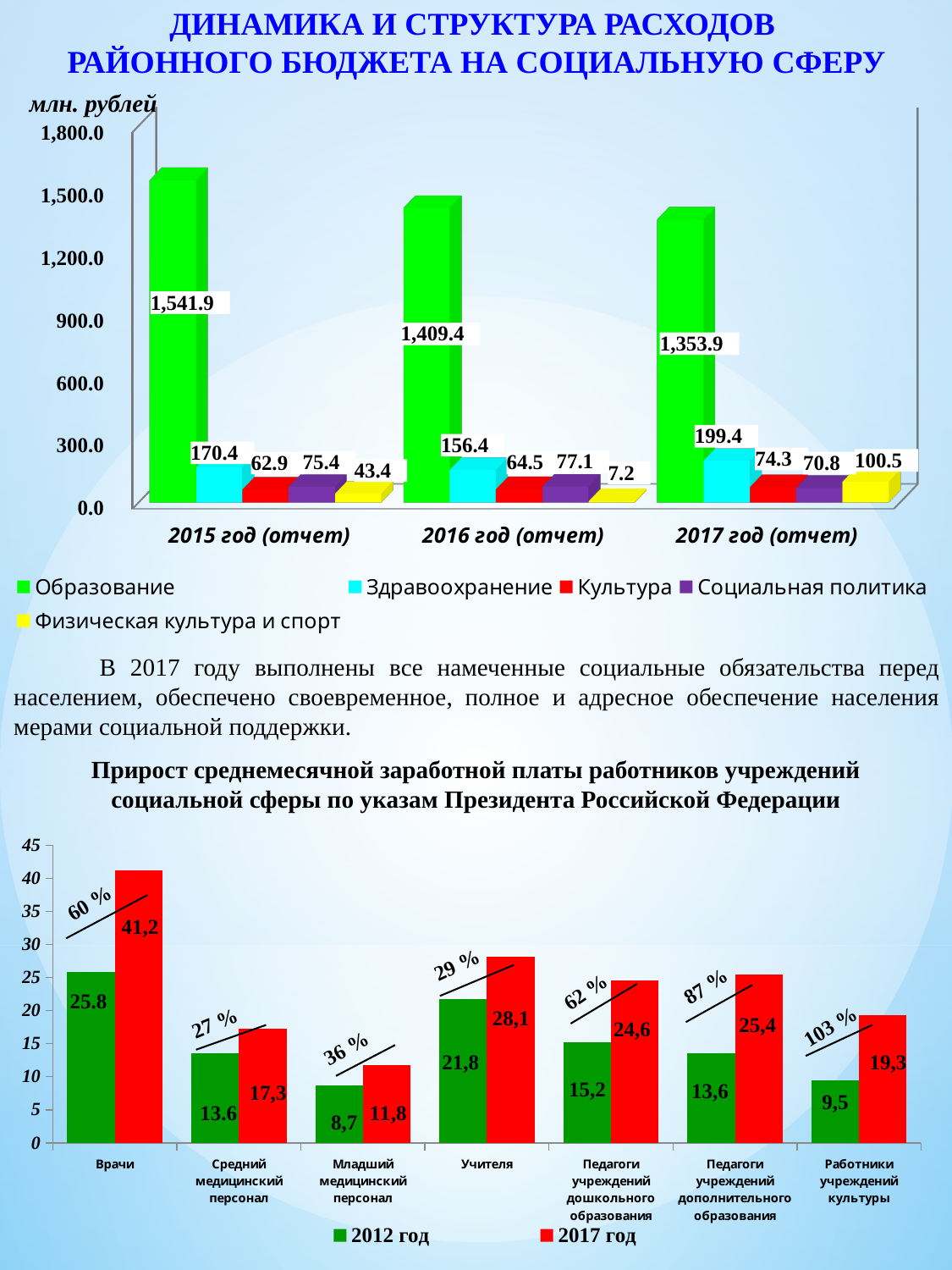
In the bottom chart (Прирост среднемесячной заработной платы), what is the 2017 год value for Врачи? 41,2 In the top chart (ДИНАМИКА И СТРУКТУРА РАСХОДОВ), what is the value for Физическая культура и спорт in 2016 год (отчет)? 7.2 How many year categories are shown on the x axis of the top chart (ДИНАМИКА И СТРУКТУРА РАСХОДОВ)? 3 What kind of chart is the bottom chart (Прирост среднемесячной заработной платы)? bar chart In the top chart (ДИНАМИКА И СТРУКТУРА РАСХОДОВ), what is the difference between the Здравоохранение values for 2017 and 2015? 29.0 In the bottom chart (Прирост среднемесячной заработной платы), which category has the lowest 2017 год value? Младший медицинский персонал In the top chart (ДИНАМИКА И СТРУКТУРА РАСХОДОВ), does the value for Образование rise or fall from 2015 to 2017? fall How many categories are shown on the x axis of the bottom chart (Прирост среднемесячной заработной платы)? 7 How many series does the legend of the top chart (ДИНАМИКА И СТРУКТУРА РАСХОДОВ) list? 5 In the bottom chart (Прирост среднемесячной заработной платы), what is the difference between the 2017 год and 2012 год values for Учителя? 6,3 In the top chart (ДИНАМИКА И СТРУКТУРА РАСХОДОВ), what is the value for Образование in 2017 год (отчет)? 1,353.9 In the bottom chart (Прирост среднемесячной заработной платы), which category has the highest 2012 год value? Врачи